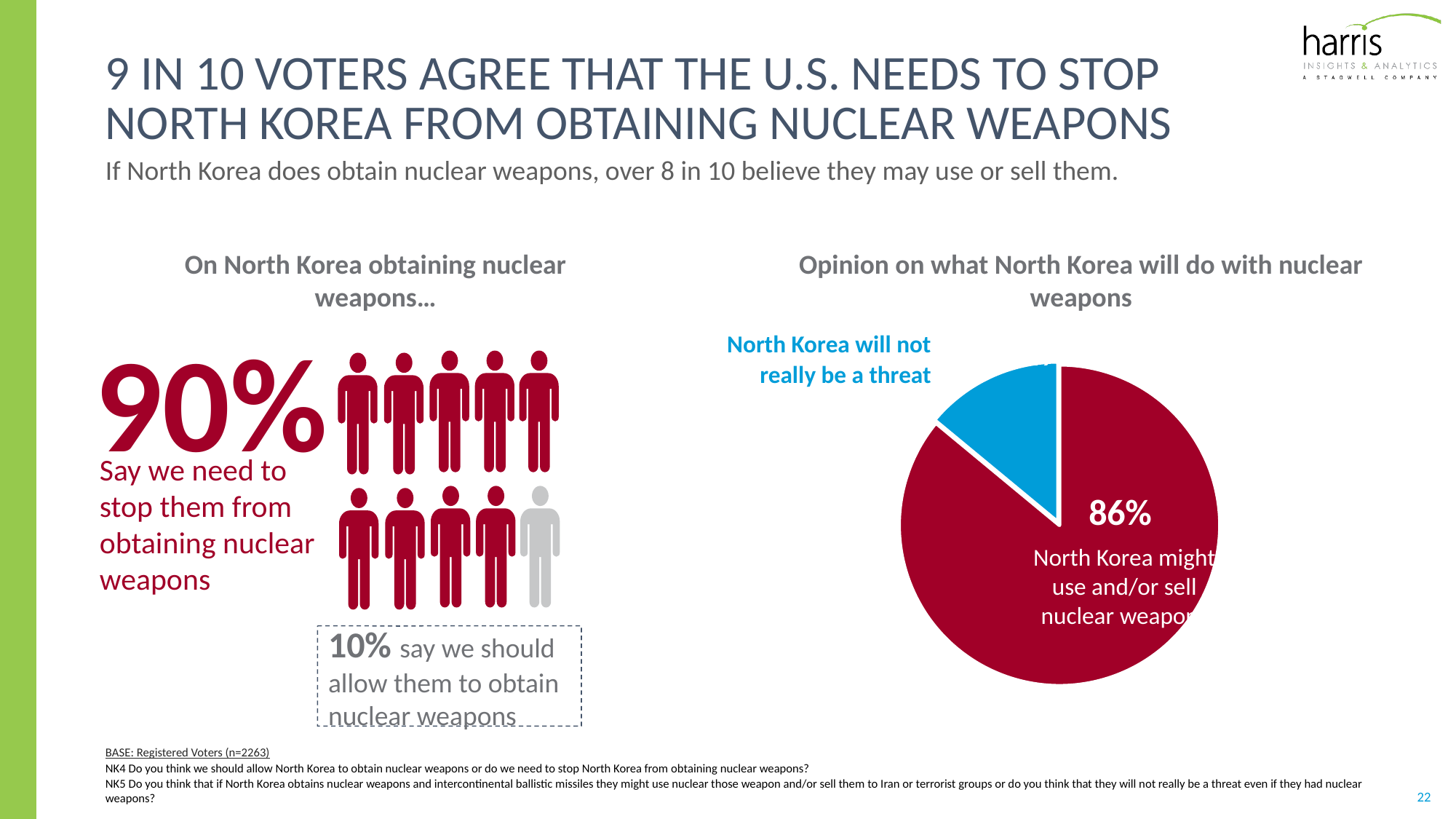
What kind of chart is shown on the right under 'Opinion on what North Korea will do with nuclear weapons'? Pie chart In the infographic on the left, what percentage of voters say we should allow North Korea to obtain nuclear weapons? 10% In the pie chart on the right, what colour is the slice labelled 'North Korea will not really be a threat'? Blue In the pie chart on the right, which slice is the smallest? North Korea will not really be a threat In the pie chart on the right, what share of voters think North Korea might use and/or sell nuclear weapons? 86% What is the title of the pie chart on the right? Opinion on what North Korea will do with nuclear weapons In the infographic on the left, how many of the person icons are grey? 1 In the pie chart on the right, which is larger: the slice for 'North Korea might use and/or sell nuclear weapons' or the slice for 'North Korea will not really be a threat'? North Korea might use and/or sell nuclear weapons In the infographic on the left, how many person icons are shown in total? 10 How many slices does the pie chart on the right have? 2 In the infographic on the left, what percentage of voters say we need to stop North Korea from obtaining nuclear weapons? 90% In the pie chart on the right, which slice is the largest? North Korea might use and/or sell nuclear weapons